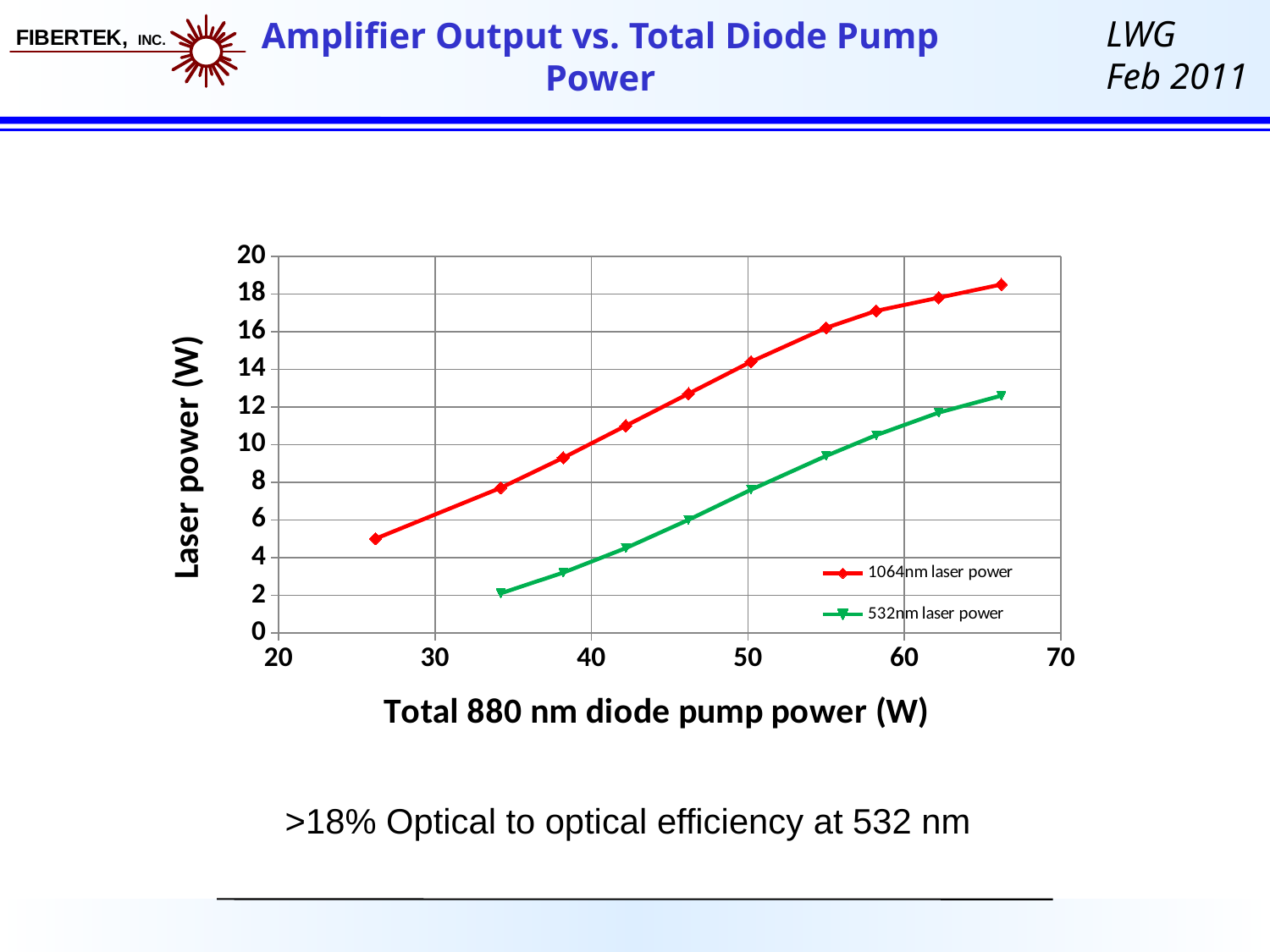
How many series does the legend list? 2 Is the highest 1064nm laser power value greater or less than 20? less What kind of chart is shown on the slide? Line chart Does the 1064nm laser power rise or fall as the diode pump power increases? Rises Does the 532nm laser power rise or fall as the diode pump power increases? Rises Is the 1064nm laser power at 50 W of pump power greater or less than 12? greater Is the 532nm laser power at 50 W of pump power greater or less than 6? greater Which series is plotted in red? 1064nm laser power What is the label of the x axis? Total 880 nm diode pump power (W) Which series has the higher laser power at 50 W of pump power, 1064nm or 532nm? 1064nm laser power